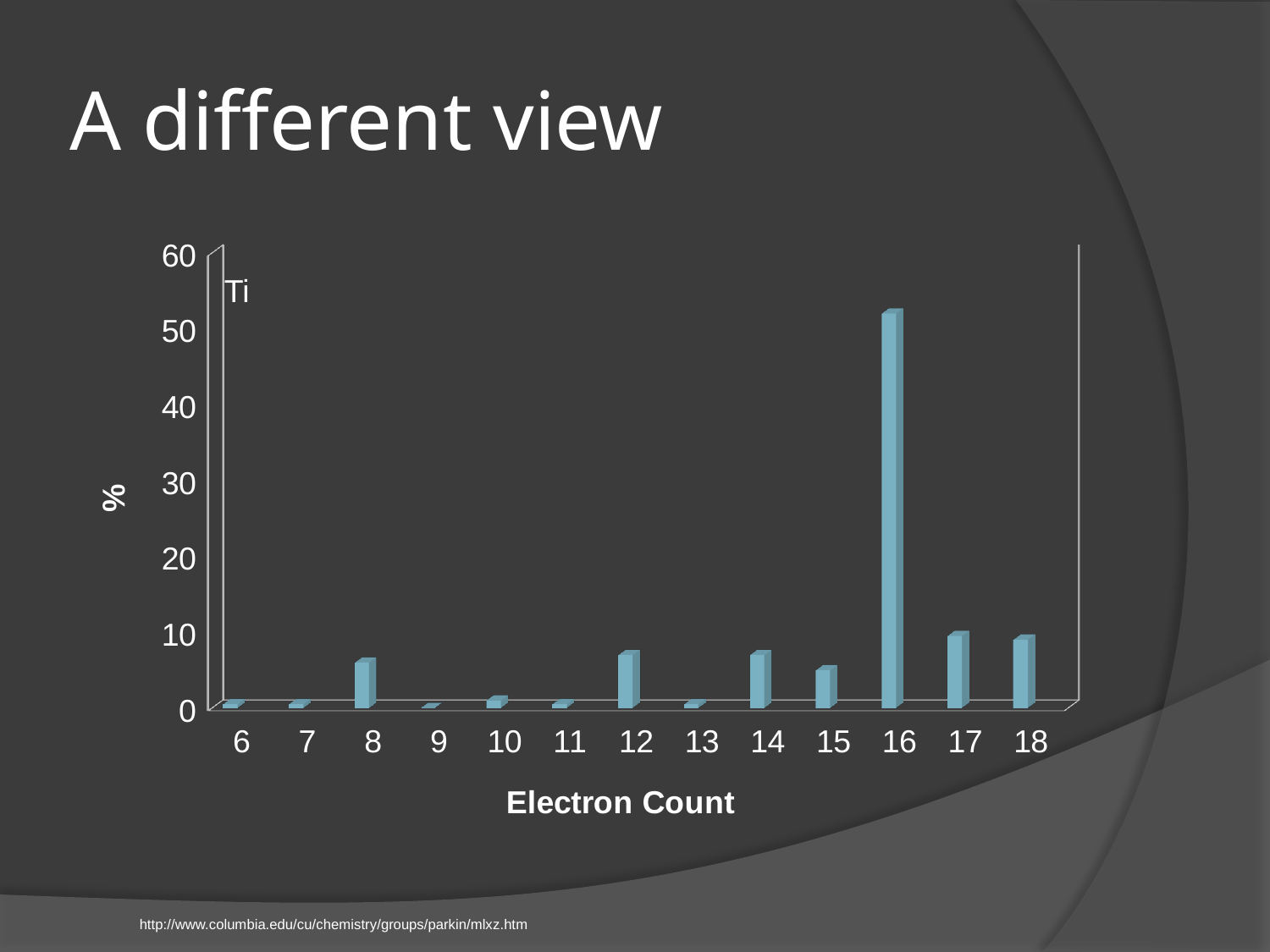
Which has the larger percentage, electron count 14 or electron count 15? 14 Which has the larger percentage, electron count 8 or electron count 10? 8 How many electron count categories are shown on the x axis? 13 Which has the larger percentage, electron count 16 or electron count 17? 16 What kind of chart is shown on the slide? bar chart What element label appears inside the plot area of the chart? Ti What is the title of the x axis? Electron Count Is the value for electron count 12 greater or less than 20? less Is the value for electron count 17 greater or less than 20? less Which electron count has the highest percentage? 16 Is the value for electron count 8 greater or less than 10? less